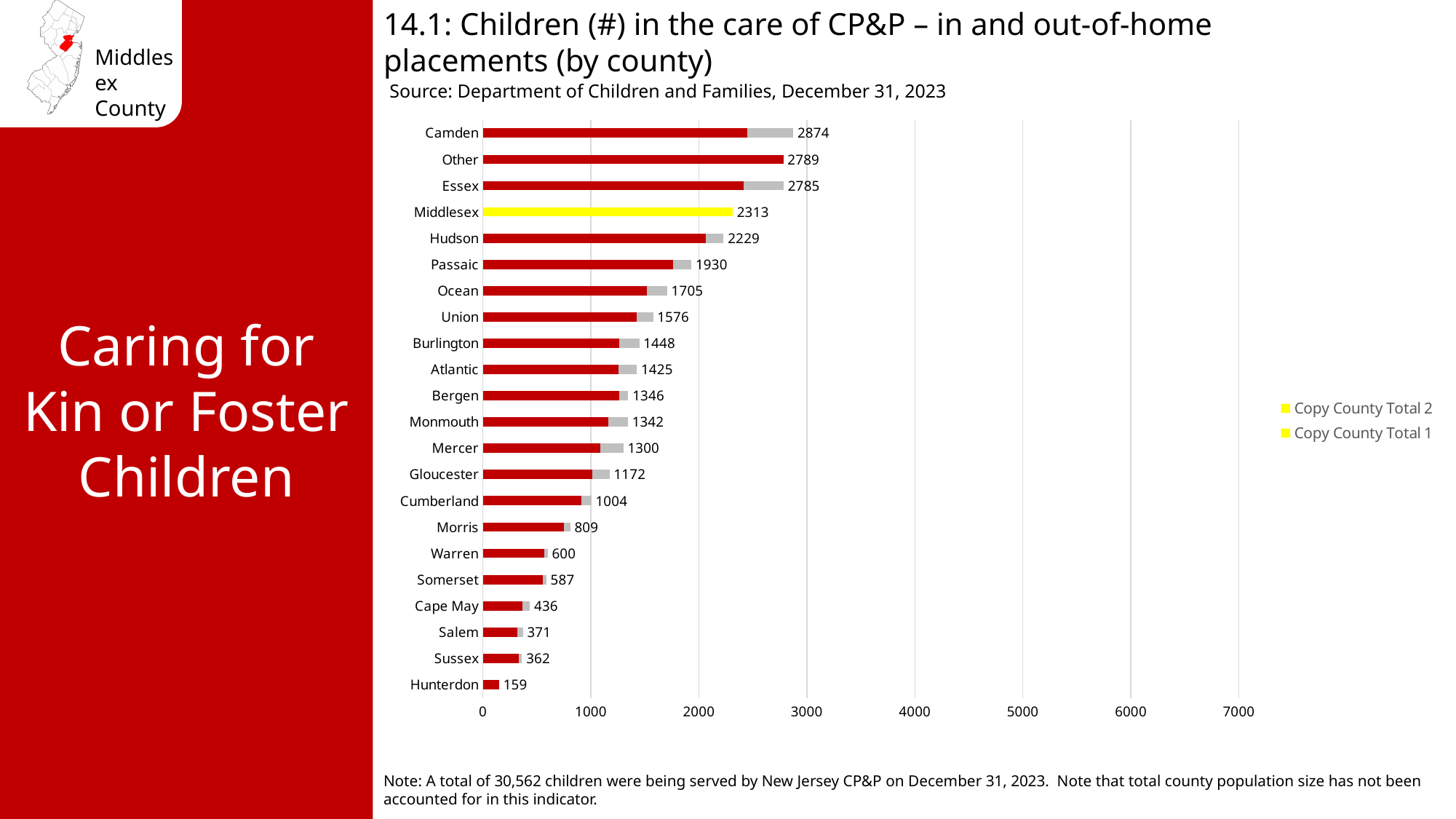
How many series does the legend list? 2 Is the value for Morris greater or less than 1000? less Which county has the lowest value on the chart? Hunterdon What colour is the bar for Middlesex? Yellow What is the value shown for Hudson? 2229 Which has a larger value, Passaic or Ocean? Passaic What is the value shown for Cumberland? 1004 What is the difference between the values for Camden and Middlesex? 561 Which county has the highest value on the chart? Camden How many counties (categories) are shown on the chart? 22 What kind of chart is shown on the slide? Bar chart What is the value shown for Middlesex? 2313